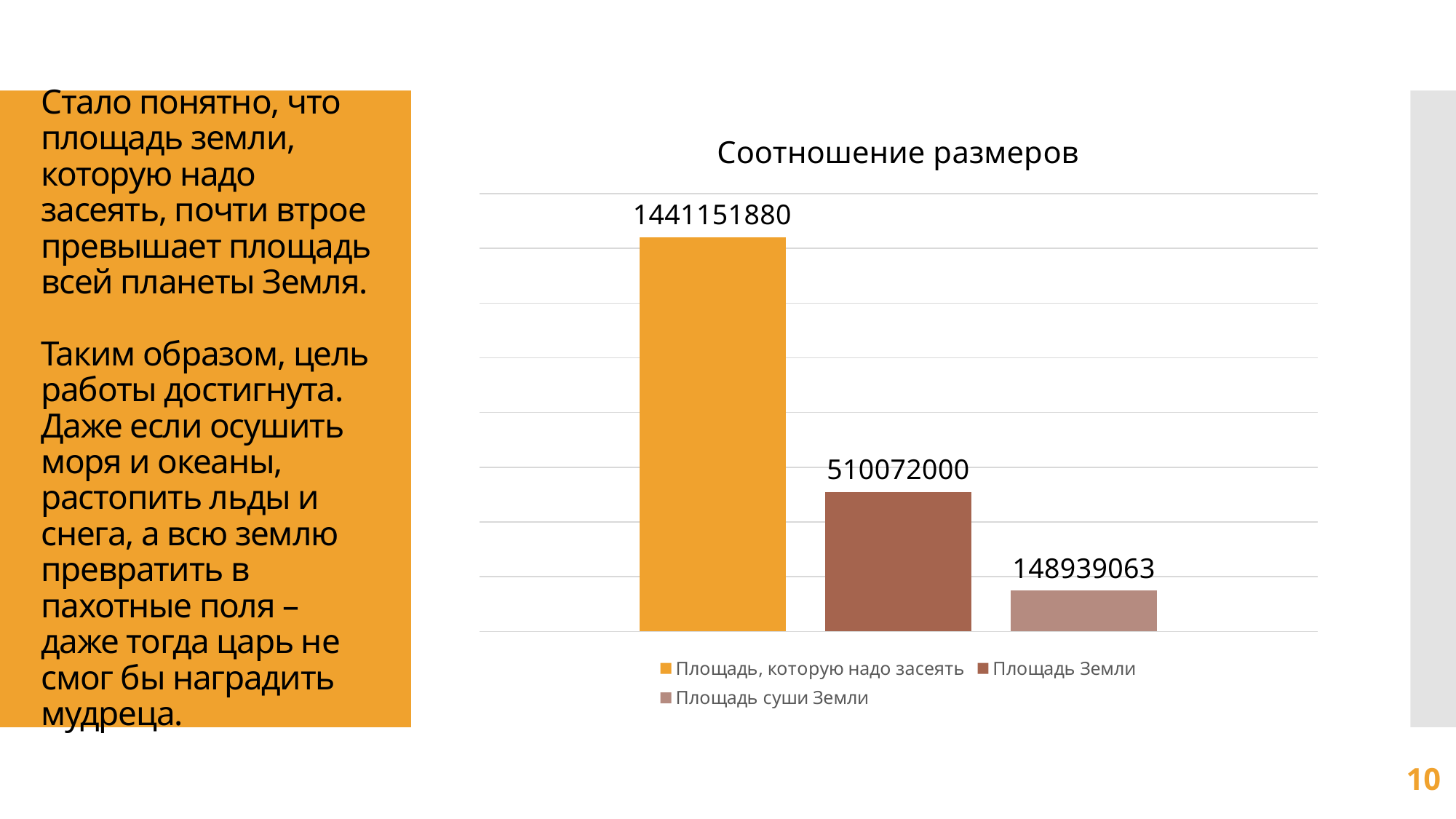
How many series does the legend list? 3 Which series has the highest value? Площадь, которую надо засеять What is the value for "Площадь, которую надо засеять"? 1441151880 How many bars are plotted in the chart? 3 What is the value for "Площадь Земли"? 510072000 What is the value for "Площадь суши Земли"? 148939063 What is the difference between "Площадь Земли" and "Площадь суши Земли"? 361132937 Which series has the lowest value? Площадь суши Земли What is the title of the chart? Соотношение размеров What kind of chart is shown on the slide? Bar chart What is the difference between "Площадь, которую надо засеять" and "Площадь Земли"? 931079880 Which is larger, "Площадь Земли" or "Площадь суши Земли"? Площадь Земли